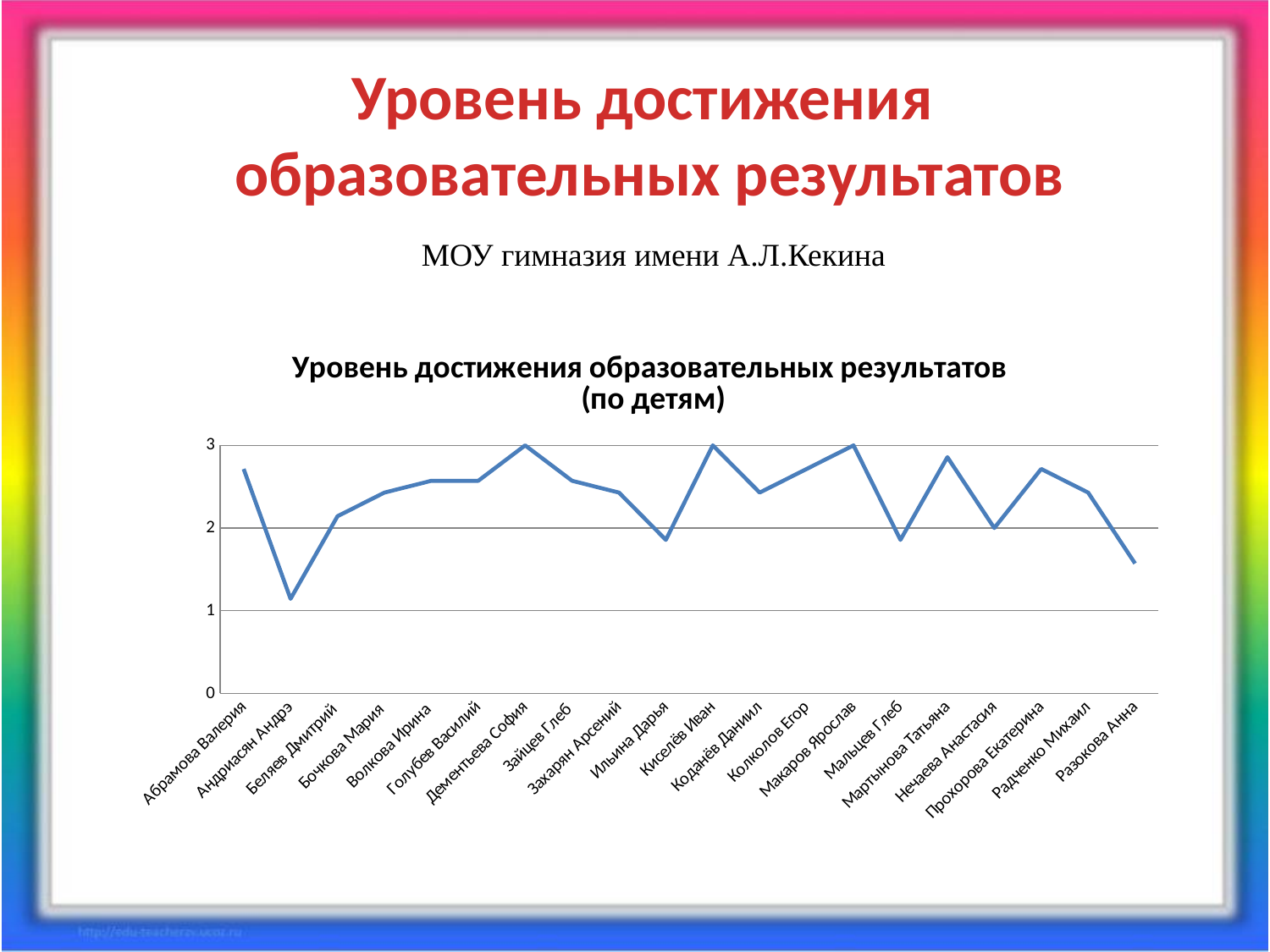
What is the value for Макаров Ярослав? 3 Do the values rise or fall from Андриасян Андрэ to Дементьева София? Rise Which child has the lowest value on the chart? Андриасян Андрэ Is the value for Мартынова Татьяна greater or less than 2? greater Is the value for Абрамова Валерия greater or less than 2? greater What is the title of the chart? Уровень достижения образовательных результатов (по детям) How many children (categories) are plotted along the x axis? 20 What is the value for Киселёв Иван? 3 What kind of chart is shown on the slide? Line chart Is the value for Разокова Анна greater or less than 2? less Which is larger, the value for Абрамова Валерия or the value for Андриасян Андрэ? Абрамова Валерия What is the value for Дементьева София? 3